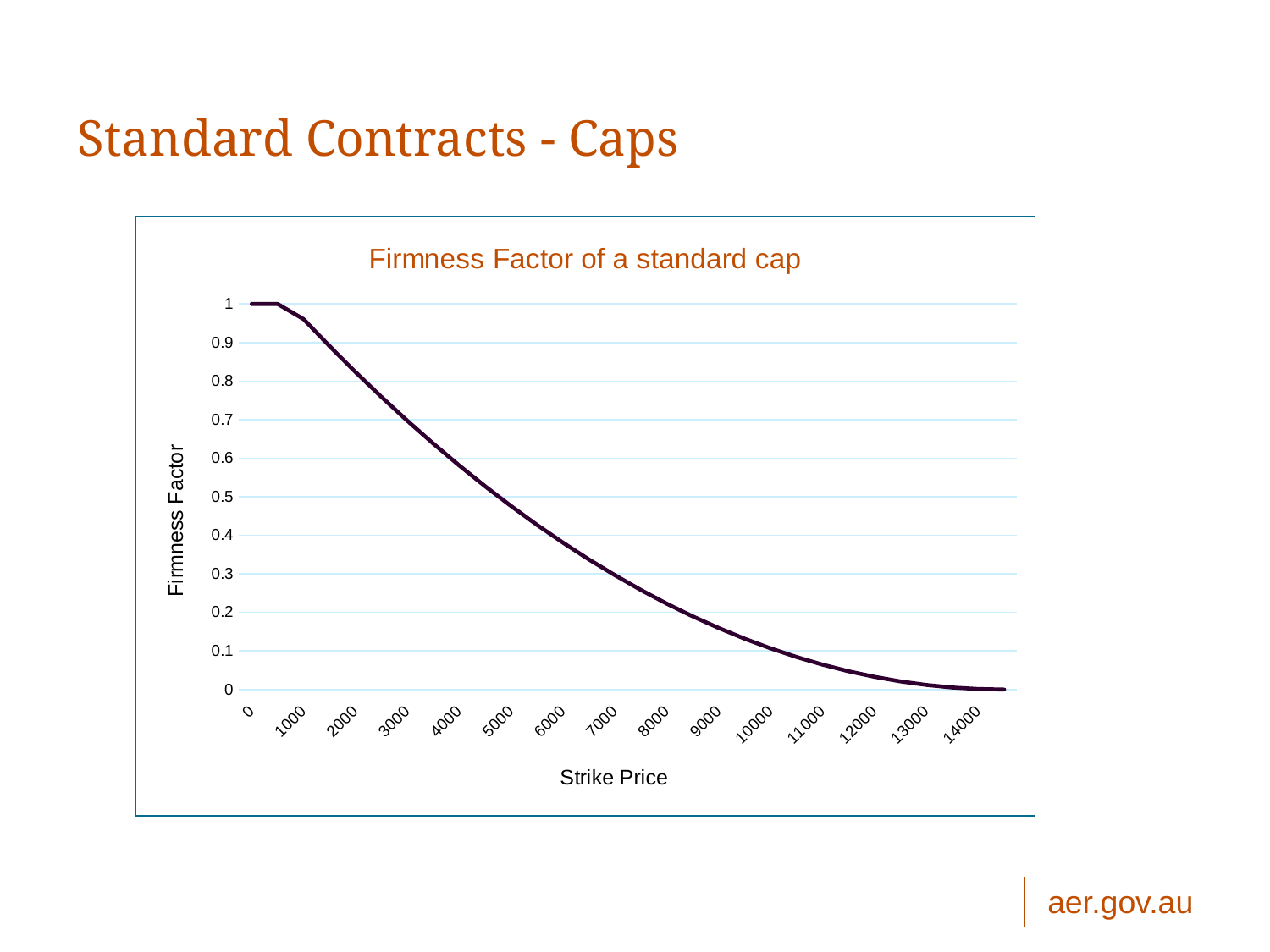
Which has the larger firmness factor, a strike price of 3000 or a strike price of 8000? 3000 What is the firmness factor at a strike price of 0? 1 How many strike price tick labels are shown on the horizontal axis? 15 What is the title of the chart? Firmness Factor of a standard cap Is the firmness factor at a strike price of 12000 greater or less than 0.1? less Is the firmness factor at a strike price of 1000 greater or less than 0.9? greater What is the label of the vertical axis? Firmness Factor Does the firmness factor rise or fall as the strike price increases? fall Is the firmness factor at a strike price of 2000 greater or less than 0.8? greater What kind of chart is shown on the slide? line chart At which strike price shown on the axis is the firmness factor highest? 0